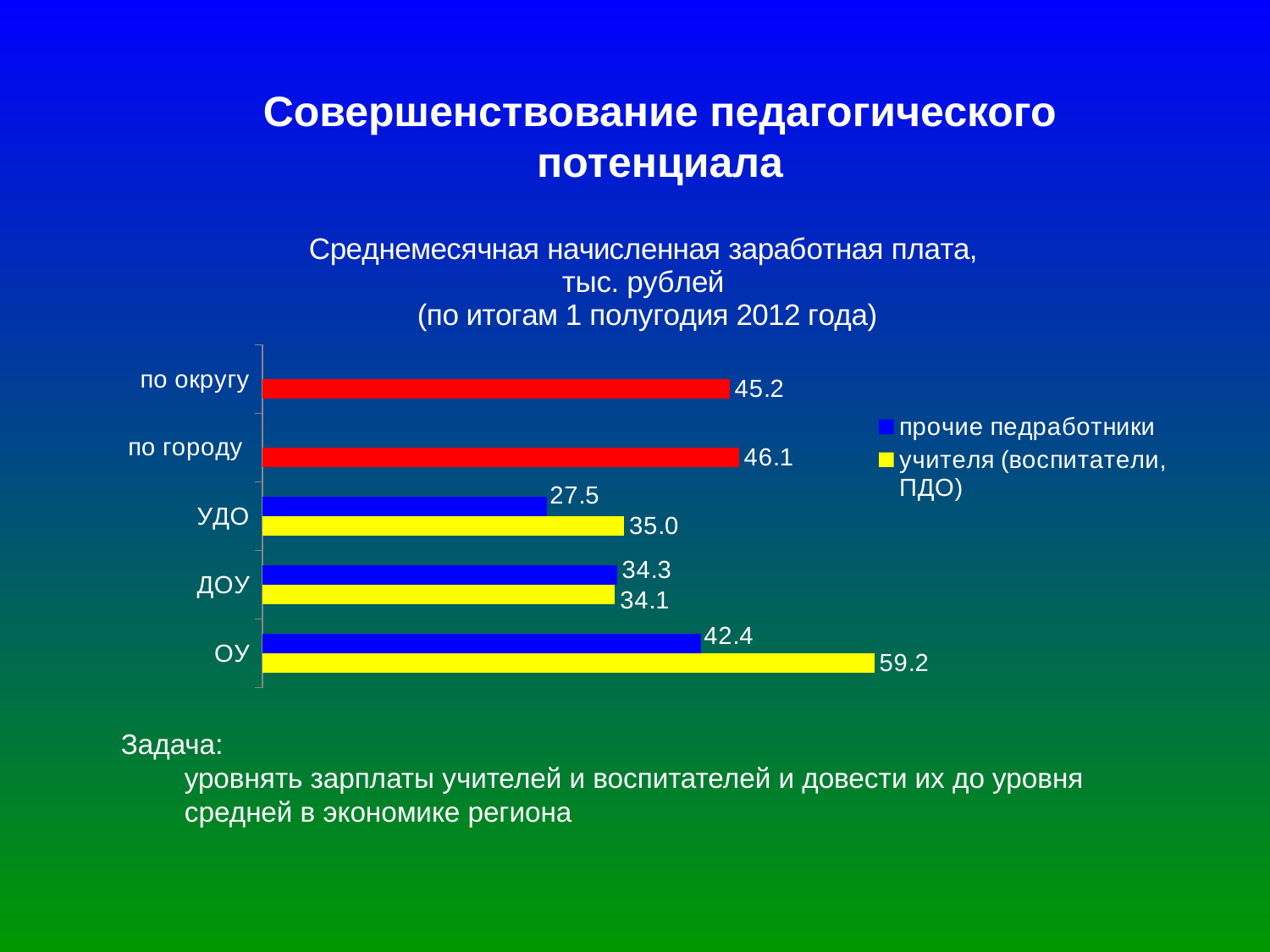
What type of chart is shown on the slide? Bar chart How many series does the chart legend list? 2 What is the difference between the учителя (воспитатели, ПДО) value and the прочие педработники value in the ОУ category? 16.8 How many categories are shown on the vertical axis of the chart? 5 Which category has the highest value for учителя (воспитатели, ПДО)? ОУ Which category has the lowest value for прочие педработники? УДО What value is shown for the по городу bar? 46.1 Which is larger: the по городу value or the по округу value? по городу What is the value for учителя (воспитатели, ПДО) in the ОУ category? 59.2 What is the difference between the учителя (воспитатели, ПДО) value and the прочие педработники value in the УДО category? 7.5 What is the value for прочие педработники in the УДО category? 27.5 What value is shown for the по округу bar? 45.2